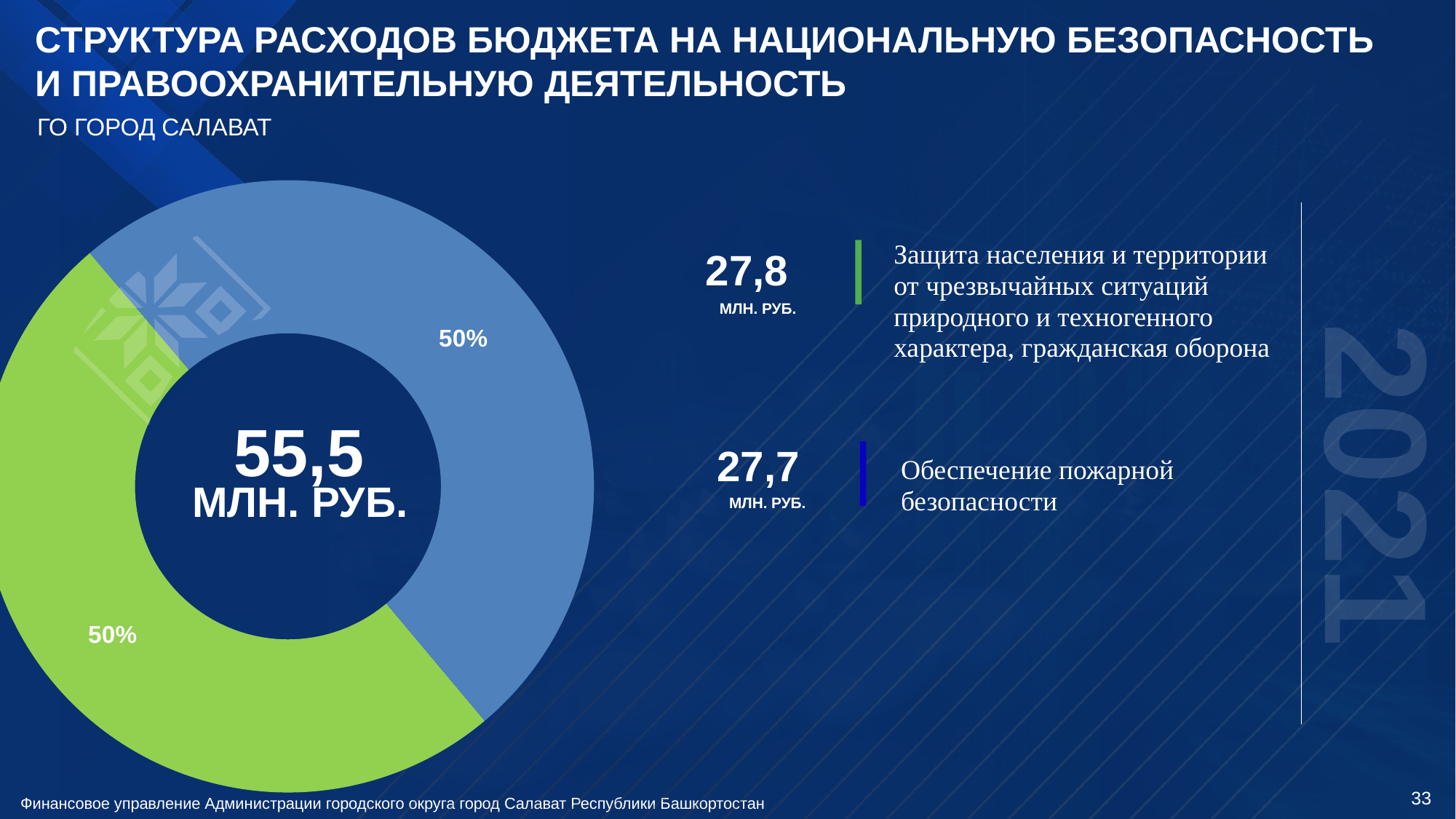
What is the value for «Обеспечение пожарной безопасности»? 27,7 млн. руб. Which has the larger printed value: «Защита населения и территории от чрезвычайных ситуаций...» or «Обеспечение пожарной безопасности»? Защита населения и территории от чрезвычайных ситуаций природного и техногенного характера, гражданская оборона What year is shown in large text on the right side of the slide? 2021 What share of the chart does the blue slice represent? 50% Which colour marks «Обеспечение пожарной безопасности» on the slide? Blue What kind of chart is shown on the slide? Pie (donut) chart What is the value for «Защита населения и территории от чрезвычайных ситуаций природного и техногенного характера, гражданская оборона»? 27,8 млн. руб. What is the difference between the value for «Защита населения и территории от чрезвычайных ситуаций...» (27,8) and «Обеспечение пожарной безопасности» (27,7)? 0,1 млн. руб. How many slices does the donut chart have? 2 What share of the chart does the green slice represent? 50% What total value is printed in the centre of the donut chart? 55,5 млн. руб.